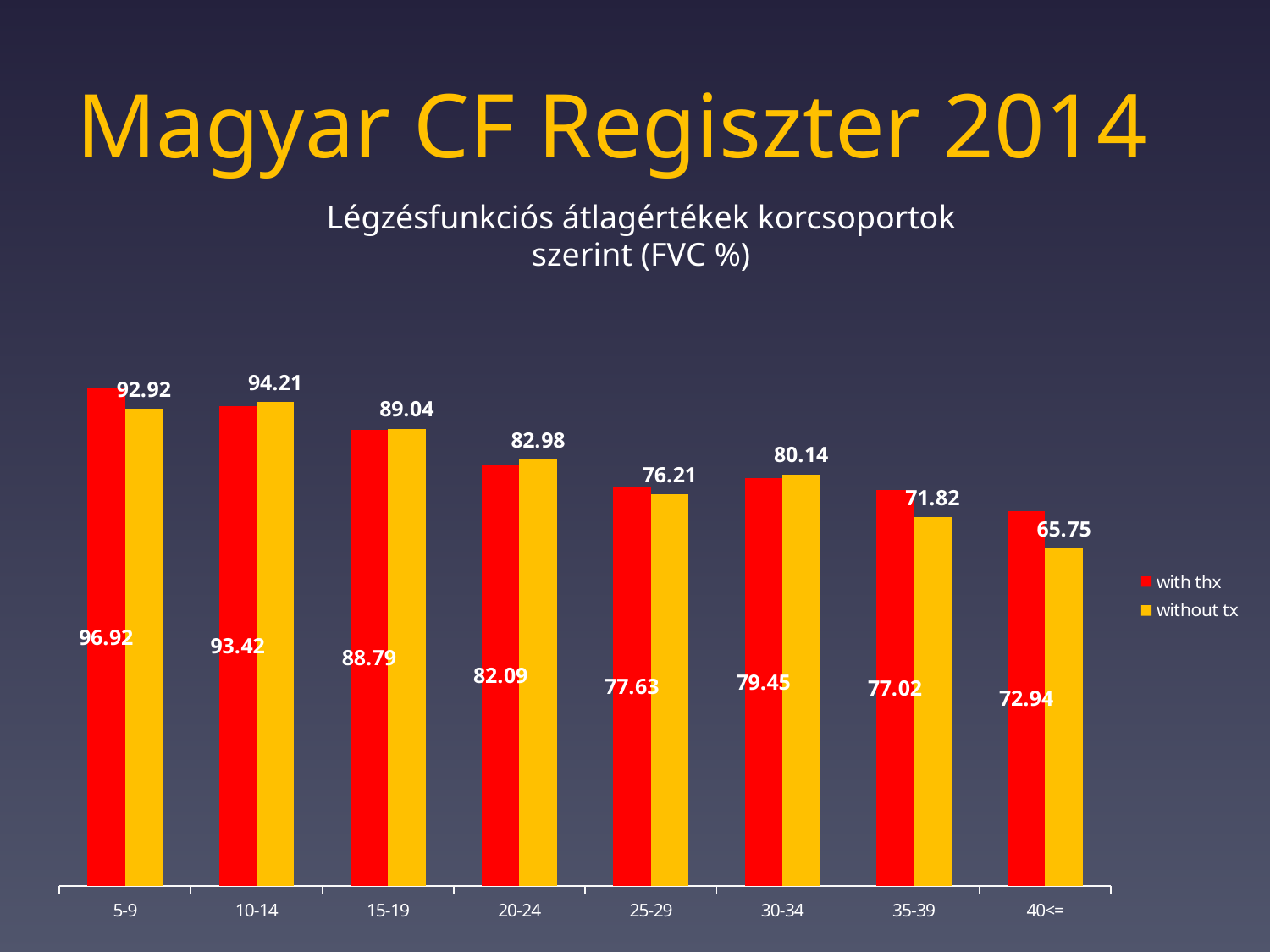
What is the value for the 'without tx' series in the 20-24 age group? 82.98 Which age group has the highest value for the 'with thx' series? 5-9 Which age group has the lowest value for the 'without tx' series? 40<= What is the value for the 'with thx' series in the 5-9 age group? 96.92 Which age group has the highest value for the 'without tx' series? 10-14 What is the value for the 'without tx' series in the 40<= age group? 65.75 In the 10-14 age group, which series has the larger value, 'with thx' or 'without tx'? without tx What kind of chart is shown on the slide? bar chart How many series does the legend list? 2 What is the difference between the 'with thx' and 'without tx' values in the 5-9 age group? 4.00 How many age groups are shown on the x axis? 8 What is the difference between the 'with thx' and 'without tx' values in the 40<= age group? 7.19